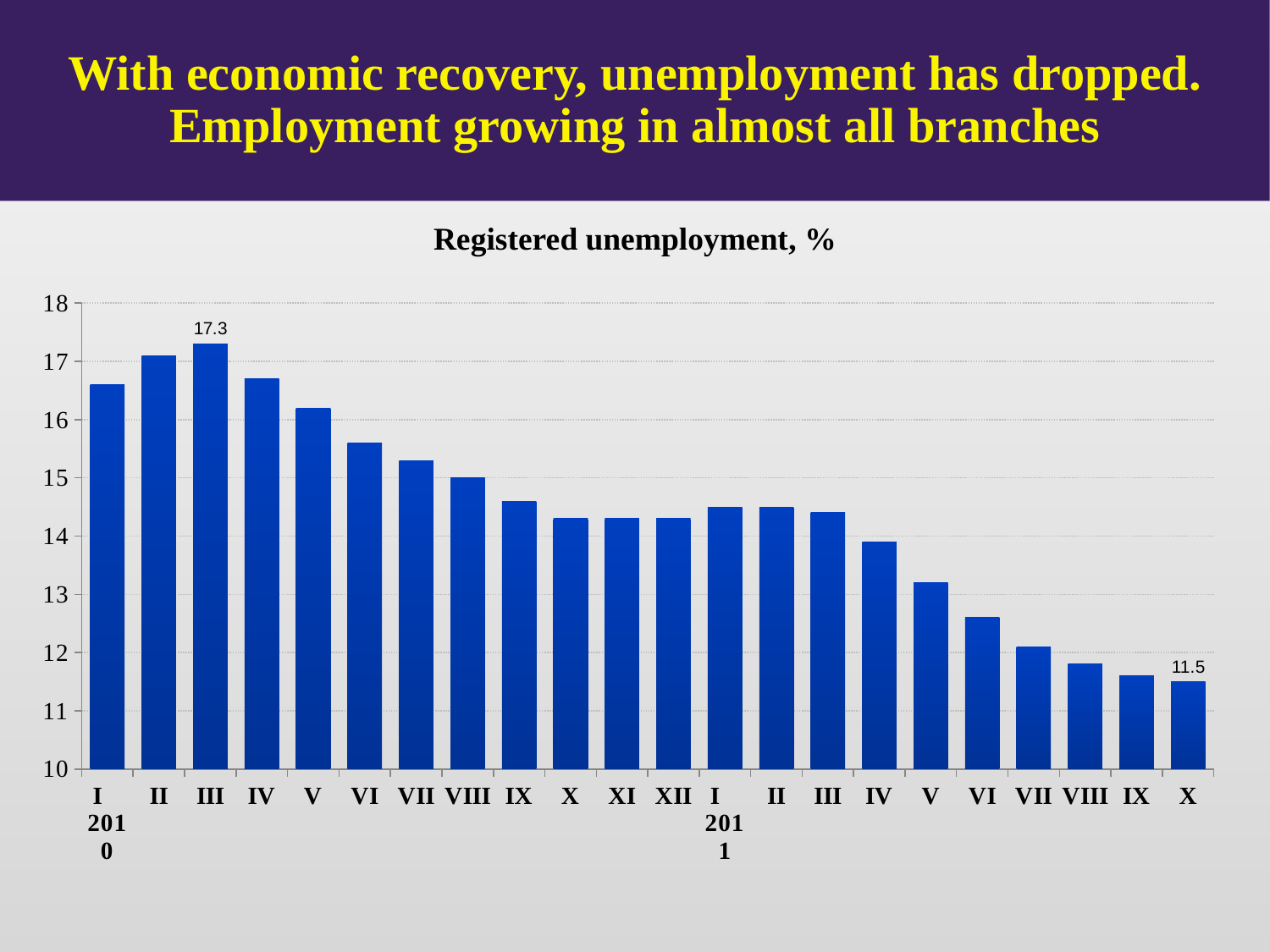
Which month has the lowest registered unemployment? X 2011 What is the difference between the registered unemployment in III 2010 and X 2011? 5.8 How many months (bars) are shown in the chart? 22 What kind of chart is shown on the slide? bar chart Is the registered unemployment value for IV 2010 greater or less than 16? greater What is the title of the chart? Registered unemployment, % Which is larger, the registered unemployment in II 2010 or in IV 2011? II 2010 What is the registered unemployment value for X 2011? 11.5 Do the registered unemployment values generally rise or fall from I 2010 to X 2011? fall Which month has the highest registered unemployment? III 2010 What is the registered unemployment value for III 2010? 17.3 Is the registered unemployment value for VI 2011 greater or less than 13? less